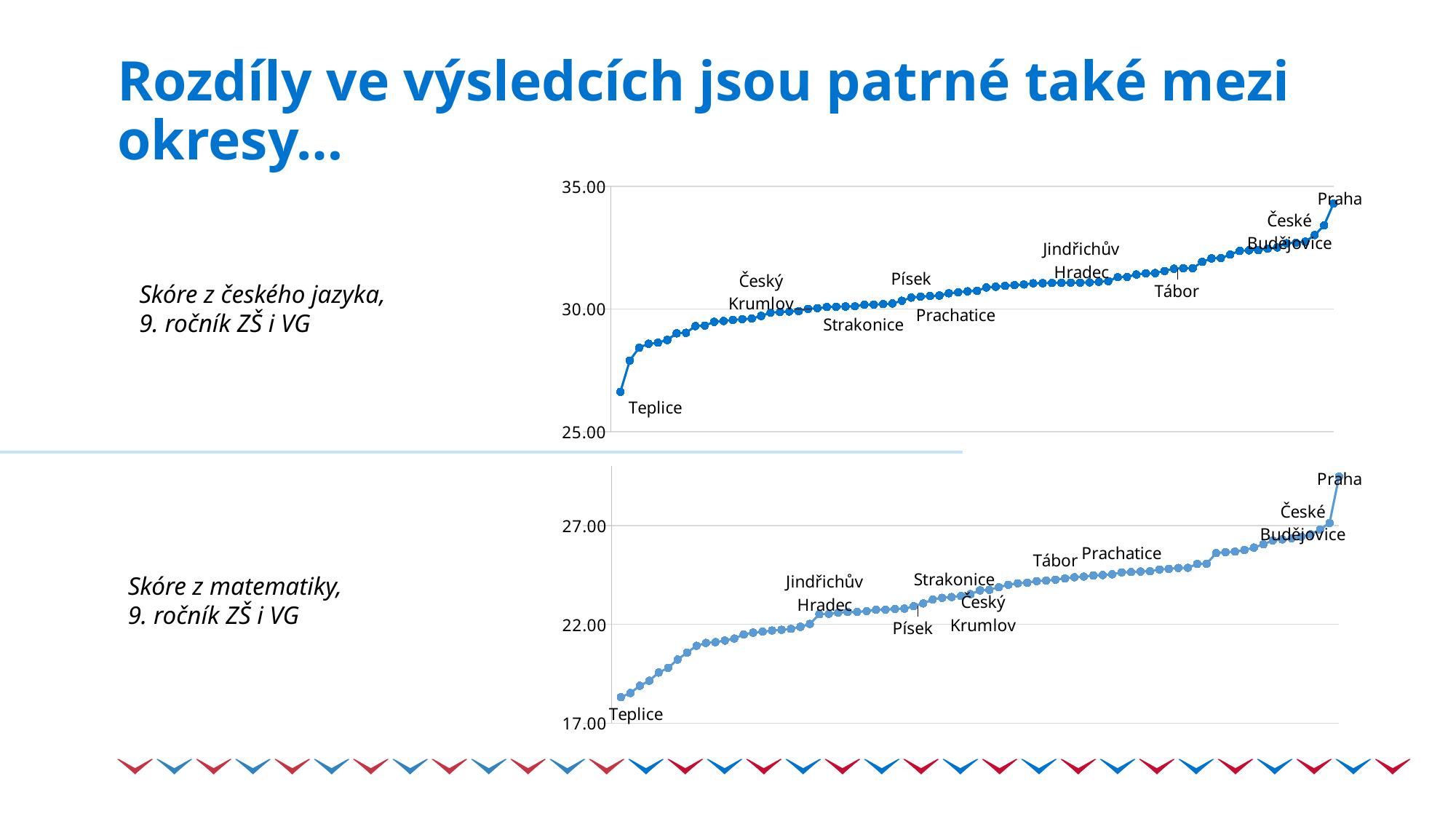
In the top chart (Skóre z českého jazyka), which labelled district has the lowest score? Teplice In the top chart (Skóre z českého jazyka), do the values rise or fall from left to right along the x axis? rise In the top chart (Skóre z českého jazyka), is the value for Teplice greater or less than 30.00? less What kind of chart is the top chart (Skóre z českého jazyka)? line chart In the bottom chart (Skóre z matematiky), which is larger, the value for Prachatice or the value for Teplice? Prachatice In the top chart (Skóre z českého jazyka), is the value for Tábor greater or less than 30.00? greater In the bottom chart (Skóre z matematiky), is the value for Praha greater or less than 27.00? greater In the bottom chart (Skóre z matematiky), which labelled district has the highest score? Praha What kind of chart is the bottom chart (Skóre z matematiky)? line chart In the bottom chart (Skóre z matematiky), which labelled district has the lowest score? Teplice In the top chart (Skóre z českého jazyka), which labelled district has the highest score? Praha